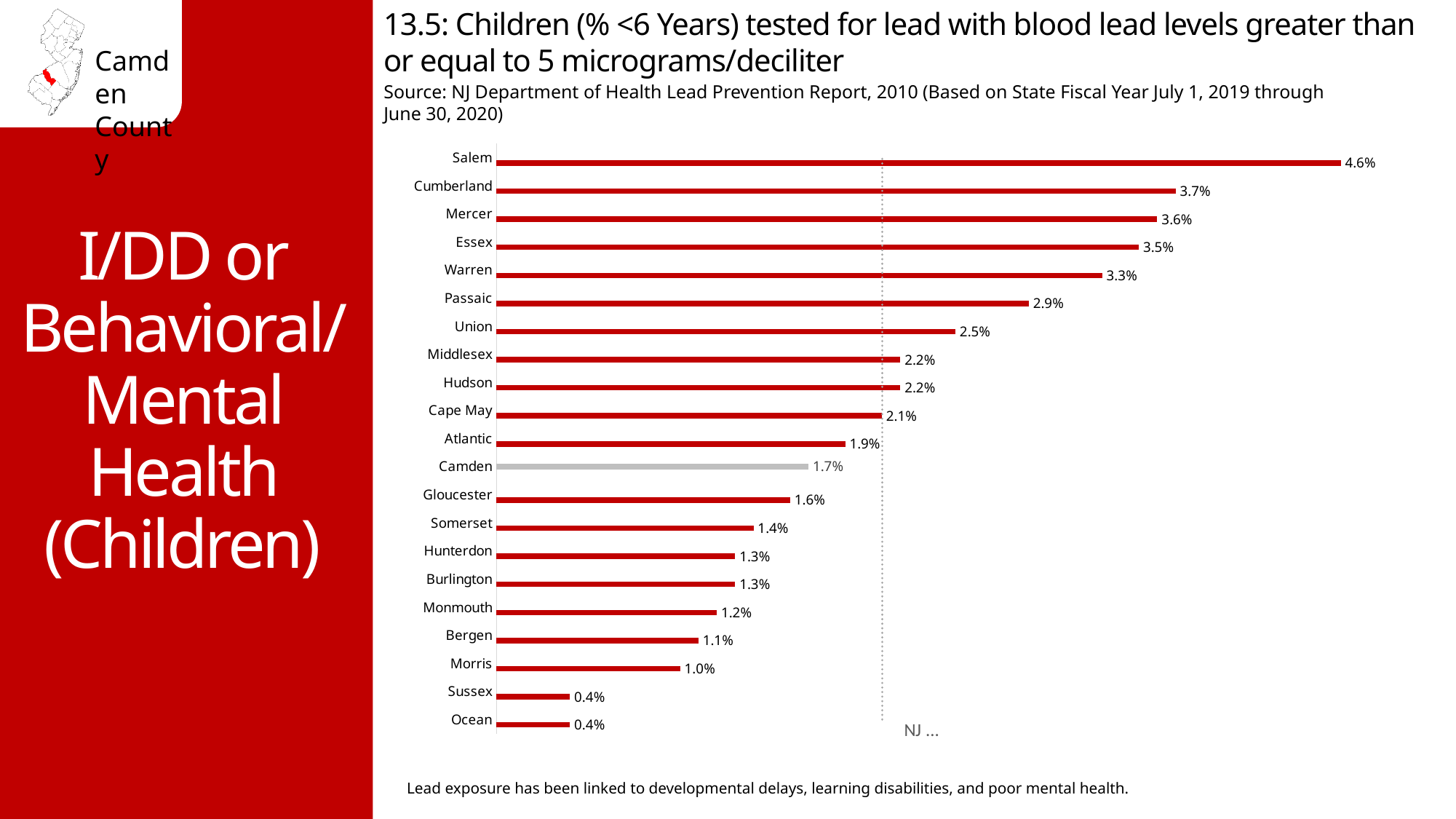
What is the value shown for Passaic? 2.9% What is the difference between the values for Camden and Atlantic? 0.2% How many counties are plotted in the chart? 21 What is the difference between the values for Salem and Cumberland? 0.9% What is the value shown for Morris? 1.0% Which is larger, the value for Gloucester or the value for Somerset? Gloucester What percentage of children tested in Camden had blood lead levels greater than or equal to 5 micrograms/deciliter? 1.7% Which county's bar is shown in grey rather than red? Camden What is the value for the highest county, Salem? 4.6% Which is larger, the value for Mercer or the value for Warren? Mercer What type of chart is shown on the slide? Bar chart Which county has the highest percentage of children with elevated blood lead levels? Salem